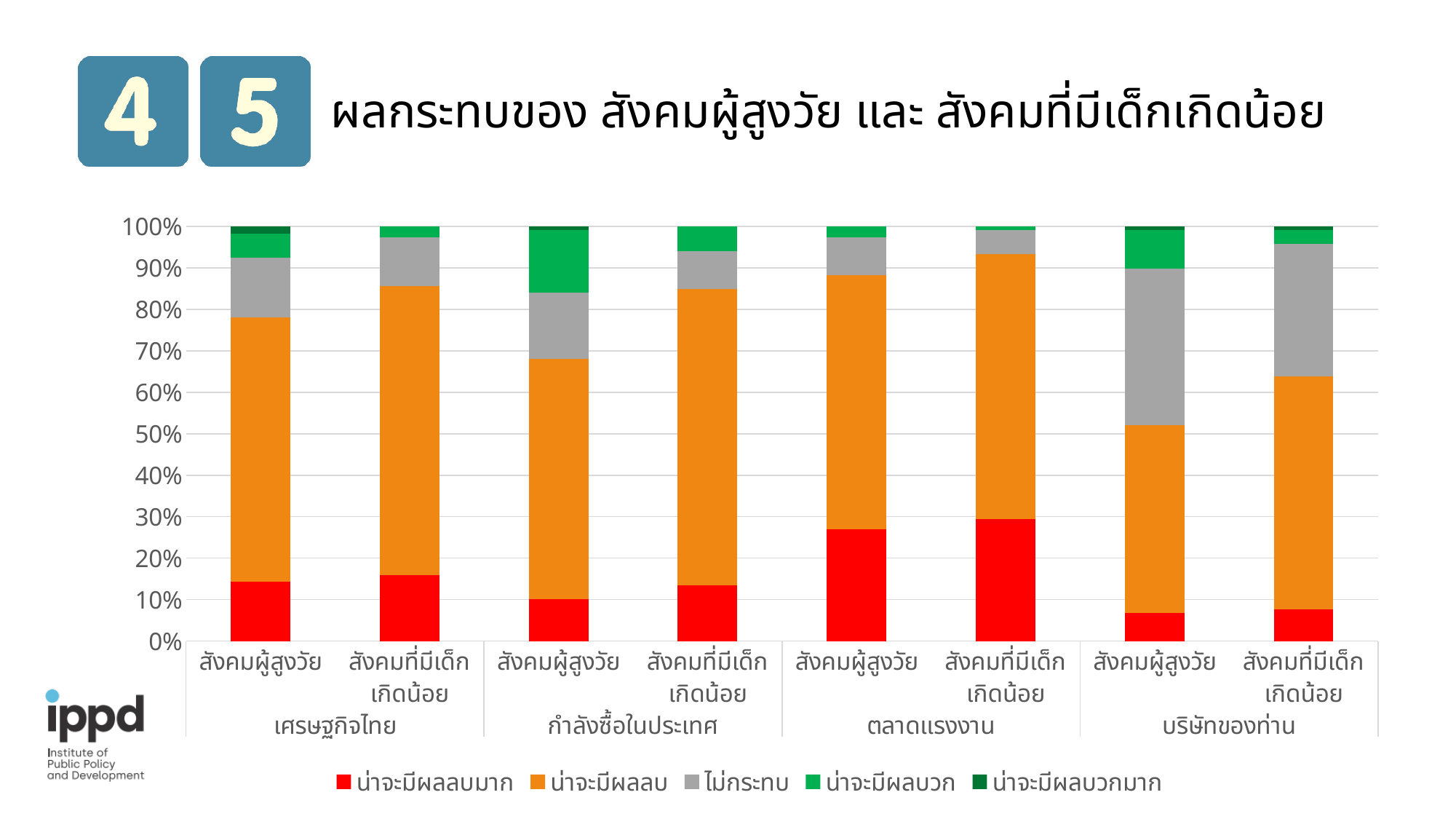
Is the combined red and orange (negative) share for สังคมผู้สูงวัย under บริษัทของท่าน greater or less than 60%? less How many series does the legend list? 5 What is the title of the slide? ผลกระทบของ สังคมผู้สูงวัย และ สังคมที่มีเด็กเกิดน้อย What is the total height of each stacked bar? 100% Which bar has the largest ไม่กระทบ (grey) segment? สังคมผู้สูงวัย under บริษัทของท่าน Is the น่าจะมีผลลบมาก (red) share for สังคมผู้สูงวัย under บริษัทของท่าน greater or less than 10%? less Is the น่าจะมีผลลบมาก (red) share for สังคมที่มีเด็กเกิดน้อย under ตลาดแรงงาน greater or less than 20%? greater How many category groups are shown along the x axis (เศรษฐกิจไทย, กำลังซื้อในประเทศ, ตลาดแรงงาน, บริษัทของท่าน)? 4 Which has the larger น่าจะมีผลลบมาก (red) segment: สังคมผู้สูงวัย under ตลาดแรงงาน or สังคมผู้สูงวัย under เศรษฐกิจไทย? สังคมผู้สูงวัย under ตลาดแรงงาน Which bar has the largest น่าจะมีผลบวก (green) segment? สังคมผู้สูงวัย under กำลังซื้อในประเทศ How many bars are plotted in the chart? 8 What kind of chart is shown on the slide? Stacked bar chart